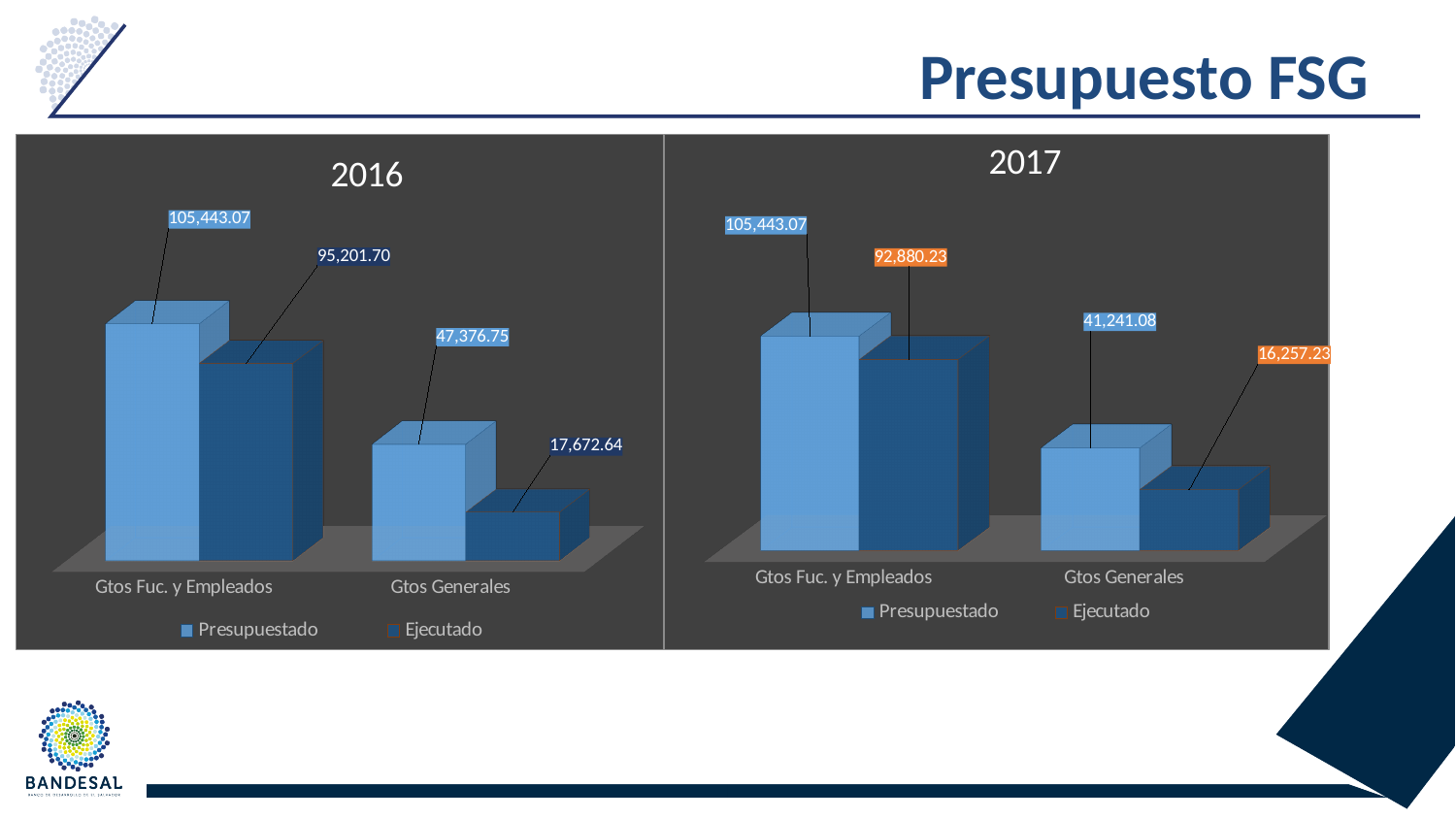
In the 2017 chart, what is the Presupuestado value for Gtos Generales? 41,241.08 In the 2016 chart, what is the Presupuestado value for Gtos Fuc. y Empleados? 105,443.07 In the 2016 chart, which is larger for Gtos Generales: Presupuestado or Ejecutado? Presupuestado How many categories are shown on the x axis of the 2016 chart? 2 In the 2017 chart, what is the Ejecutado value for Gtos Fuc. y Empleados? 92,880.23 In the 2016 chart, which category has the lowest Ejecutado value? Gtos Generales In the 2016 chart, what is the Ejecutado value for Gtos Generales? 17,672.64 In the 2017 chart, what is the difference between the Presupuestado and Ejecutado values for Gtos Generales? 24,983.85 How many series does the legend of the 2017 chart list? 2 In the 2017 chart, which category has the highest Presupuestado value? Gtos Fuc. y Empleados What kind of chart is the 2017 chart? Bar chart In the 2016 chart, what is the difference between the Presupuestado and Ejecutado values for Gtos Fuc. y Empleados? 10,241.37